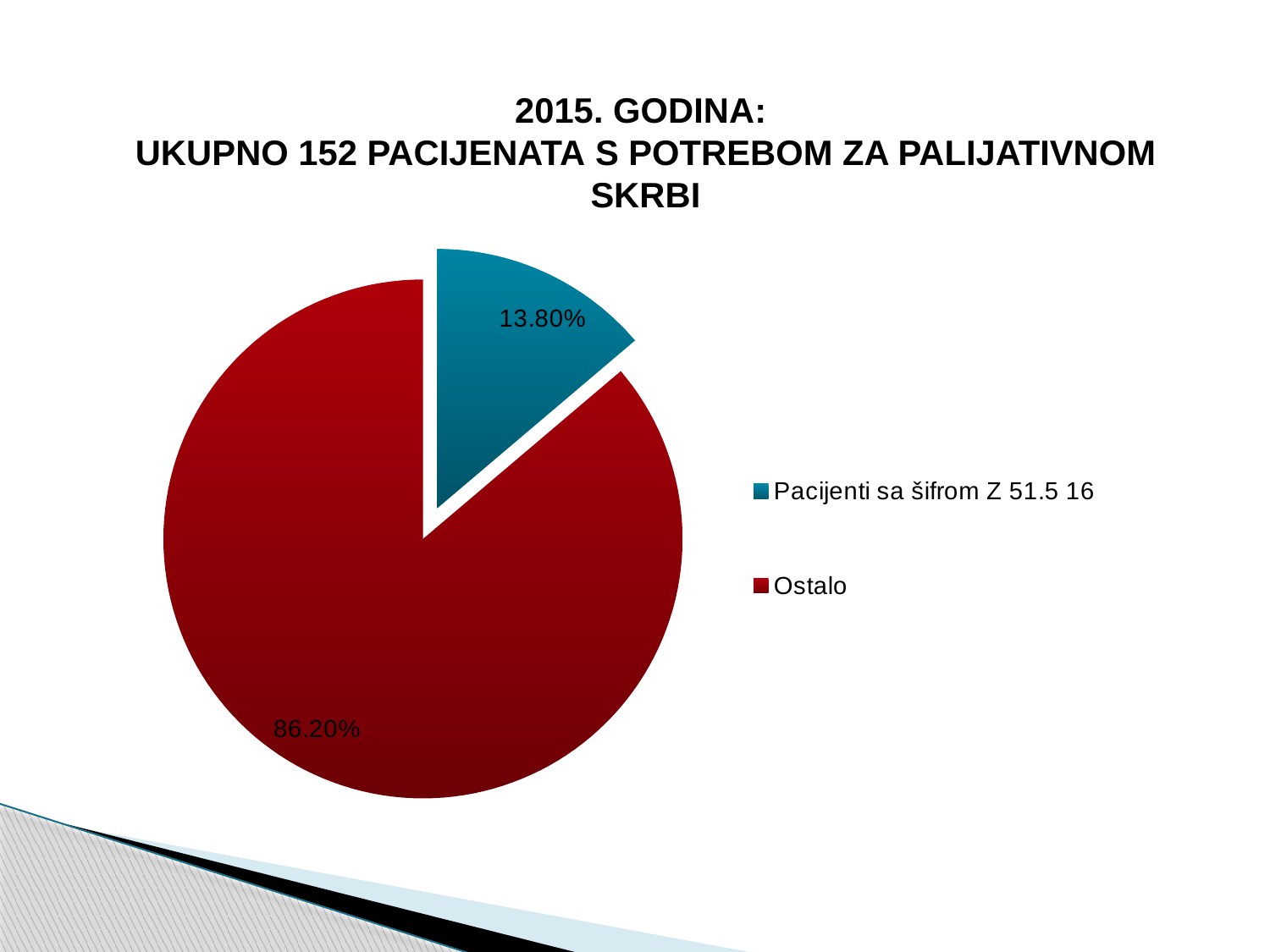
According to the slide title, how many patients in total needed palliative care in 2015? 152 What share of the pie does "Pacijenti sa šifrom Z 51.5 16" represent? 13.80% How many slices does the pie chart have? 2 What colour is the "Ostalo" slice? red Which slice is the smallest? Pacijenti sa šifrom Z 51.5 16 What is the difference in percentage points between the "Ostalo" slice and the "Pacijenti sa šifrom Z 51.5 16" slice? 72.40% What share of the pie does "Ostalo" represent? 86.20% Which is larger, the "Ostalo" slice or the "Pacijenti sa šifrom Z 51.5 16" slice? Ostalo What kind of chart is shown on the slide? pie chart Which slice is the largest? Ostalo How many entries does the legend list? 2